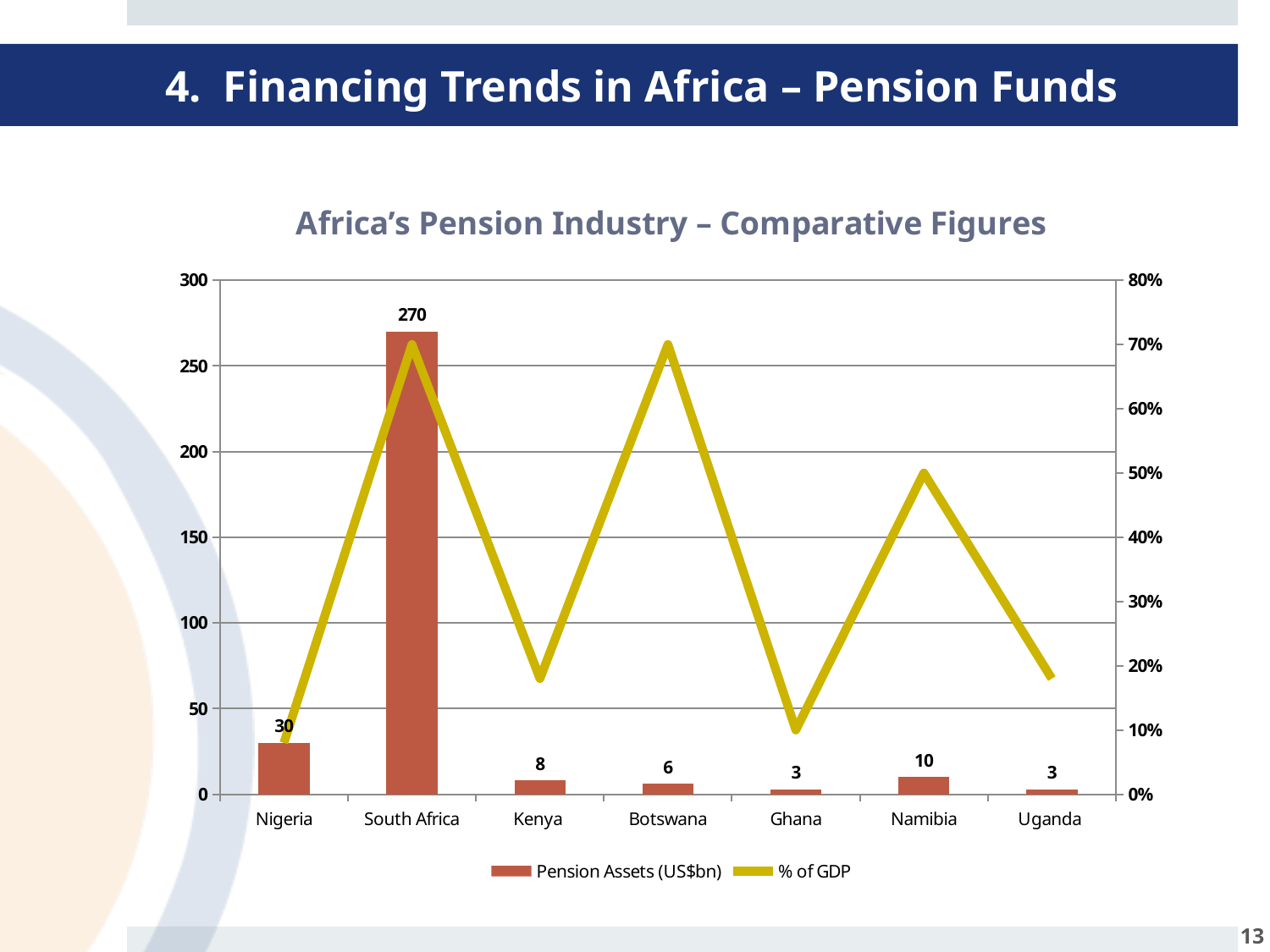
What is the difference in Pension Assets (US$bn) between South Africa and Nigeria? 240 Which has larger Pension Assets (US$bn), Kenya or Botswana? Kenya Which country has the highest Pension Assets (US$bn)? South Africa How many series does the legend list? 2 Is the % of GDP value for Ghana greater or less than 20%? less What is the title of the chart? Africa's Pension Industry – Comparative Figures What is the Pension Assets (US$bn) value for Nigeria? 30 How many countries are shown on the x axis? 7 Is the % of GDP value for Namibia greater or less than 40%? greater Is the % of GDP value for South Africa greater or less than 60%? greater What is the Pension Assets (US$bn) value for South Africa? 270 What is the Pension Assets (US$bn) value for Namibia? 10